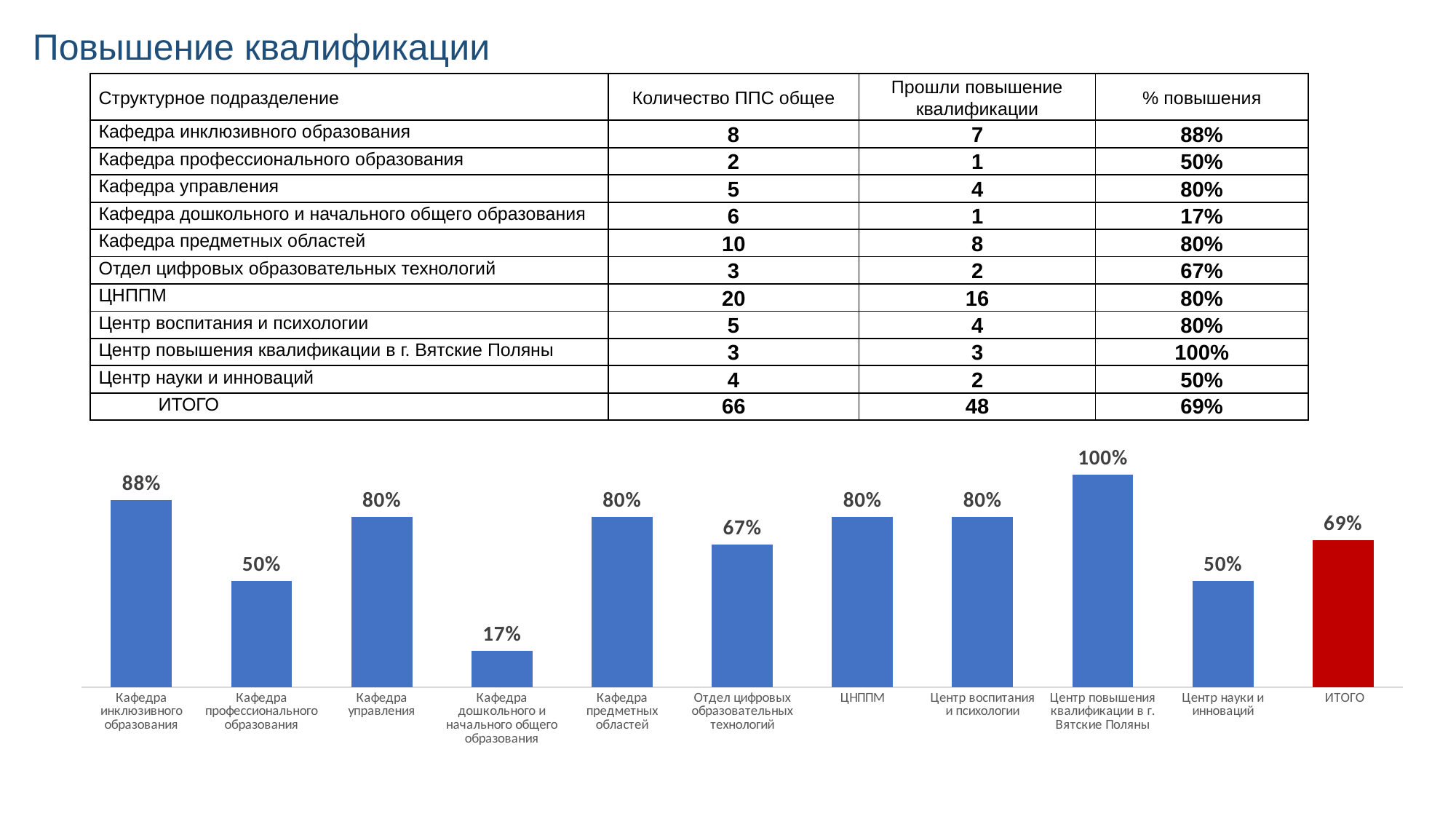
Which category has the lowest value in the bar chart? Кафедра дошкольного и начального общего образования What kind of chart is shown on the slide? Bar chart How many categories in the bar chart have a value of 80%? 4 What is the difference between the values for Кафедра инклюзивного образования and Кафедра профессионального образования in the bar chart? 38% Which category has the highest value in the bar chart? Центр повышения квалификации в г. Вятские Поляны Which bar in the chart is coloured red rather than blue? ИТОГО How many bars are shown in the bar chart? 11 What is the value shown for Кафедра дошкольного и начального общего образования in the bar chart? 17% Which is larger in the bar chart: the value for ЦНППМ or the value for Центр науки и инноваций? ЦНППМ What is the value shown for Кафедра инклюзивного образования in the bar chart? 88% What is the value shown for Отдел цифровых образовательных технологий in the bar chart? 67% What is the value shown for ИТОГО in the bar chart? 69%